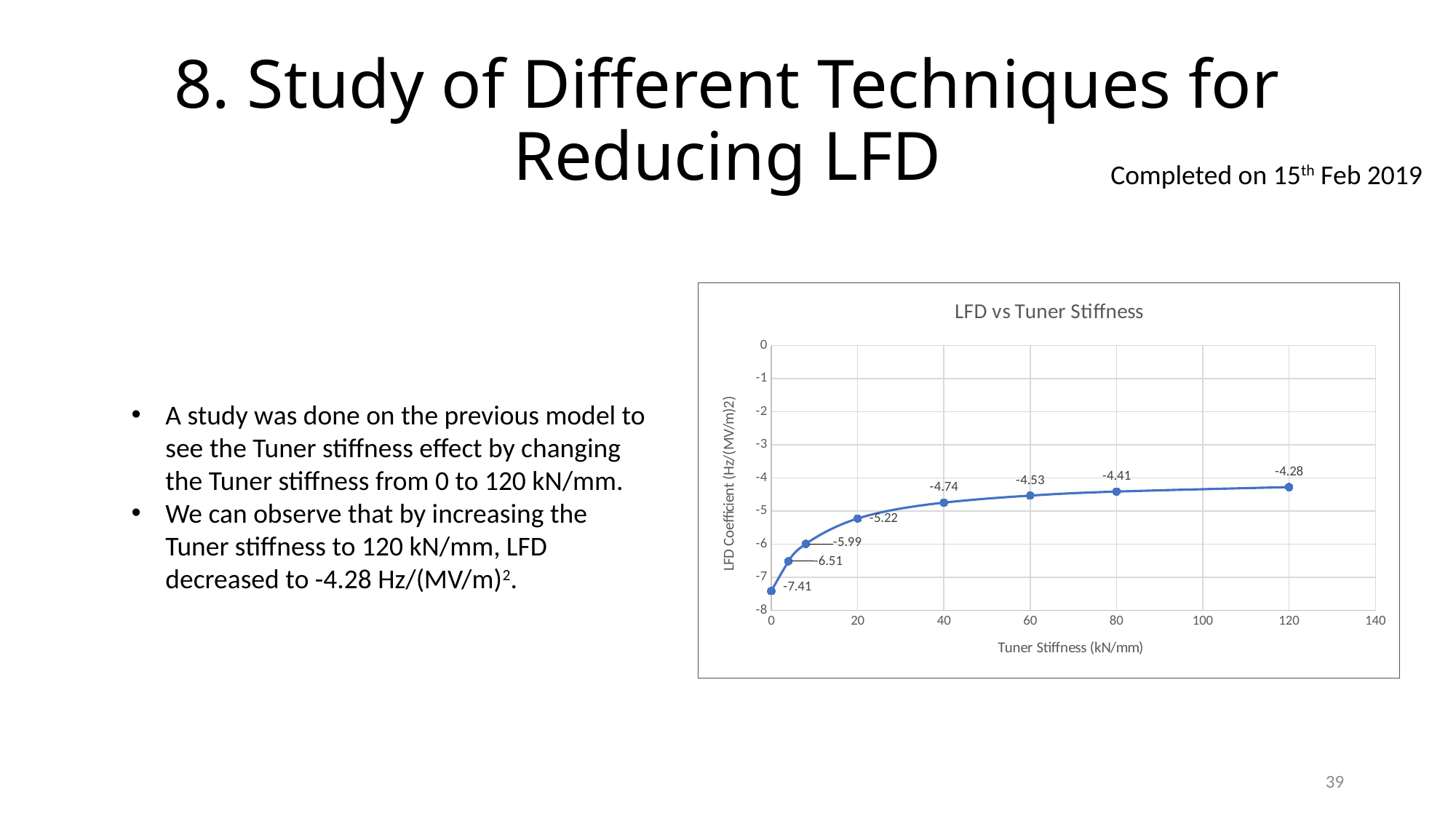
What is the lowest LFD coefficient value plotted on the chart? -7.41 Does the LFD coefficient rise or fall as tuner stiffness increases along the x axis? Rise What kind of chart is shown on the slide? Line chart How many data points are plotted on the chart? 8 At which tuner stiffness is the LFD coefficient highest (closest to zero)? 120 kN/mm What is the difference between the LFD coefficient at 20 kN/mm and at 60 kN/mm? 0.69 Which is larger, the LFD coefficient at 60 kN/mm or at 80 kN/mm? 80 kN/mm What is the LFD coefficient at a tuner stiffness of 40 kN/mm? -4.74 What is the LFD coefficient at a tuner stiffness of 0 kN/mm? -7.41 What is the difference between the LFD coefficient at 0 kN/mm and at 120 kN/mm? 3.13 What is the LFD coefficient at a tuner stiffness of 120 kN/mm? -4.28 What is the LFD coefficient at a tuner stiffness of 80 kN/mm? -4.41